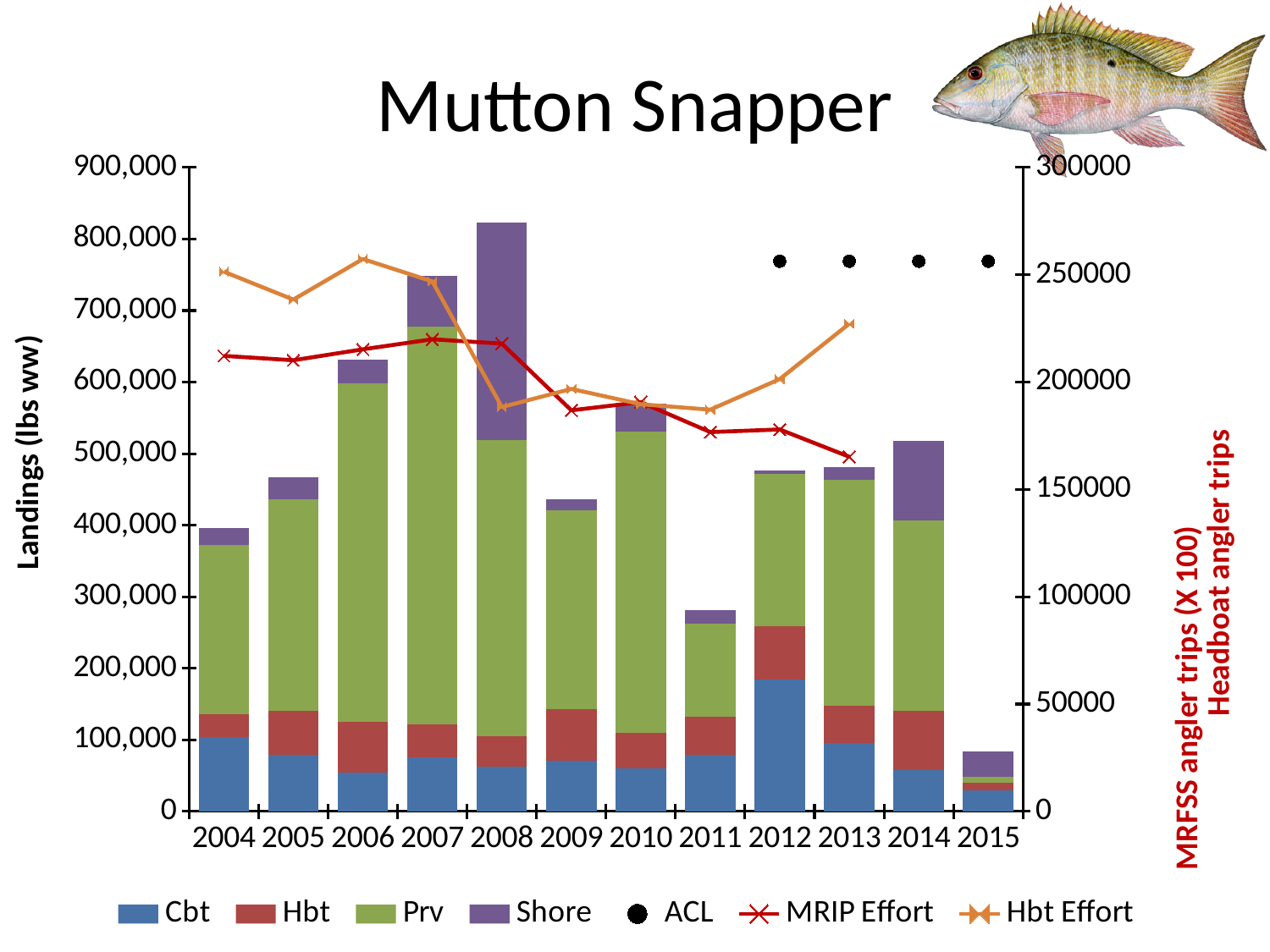
What is the title of the chart? Mutton Snapper Is the Cbt value for 2012 greater or less than 100,000? greater How many years are shown along the x axis? 12 Is the total landings value for 2015 greater or less than 100,000? less What kind of chart is shown on the slide? Stacked bar chart with line series Which year has the highest total landings bar? 2008 How many series does the legend list? 7 Which year has the largest Cbt segment? 2012 Which year has a larger total landings bar, 2005 or 2006? 2006 Is the total landings value for 2007 greater or less than 700,000? greater Which year has the lowest total landings bar? 2015 Does the MRIP Effort line rise or fall from 2008 to 2013? fall